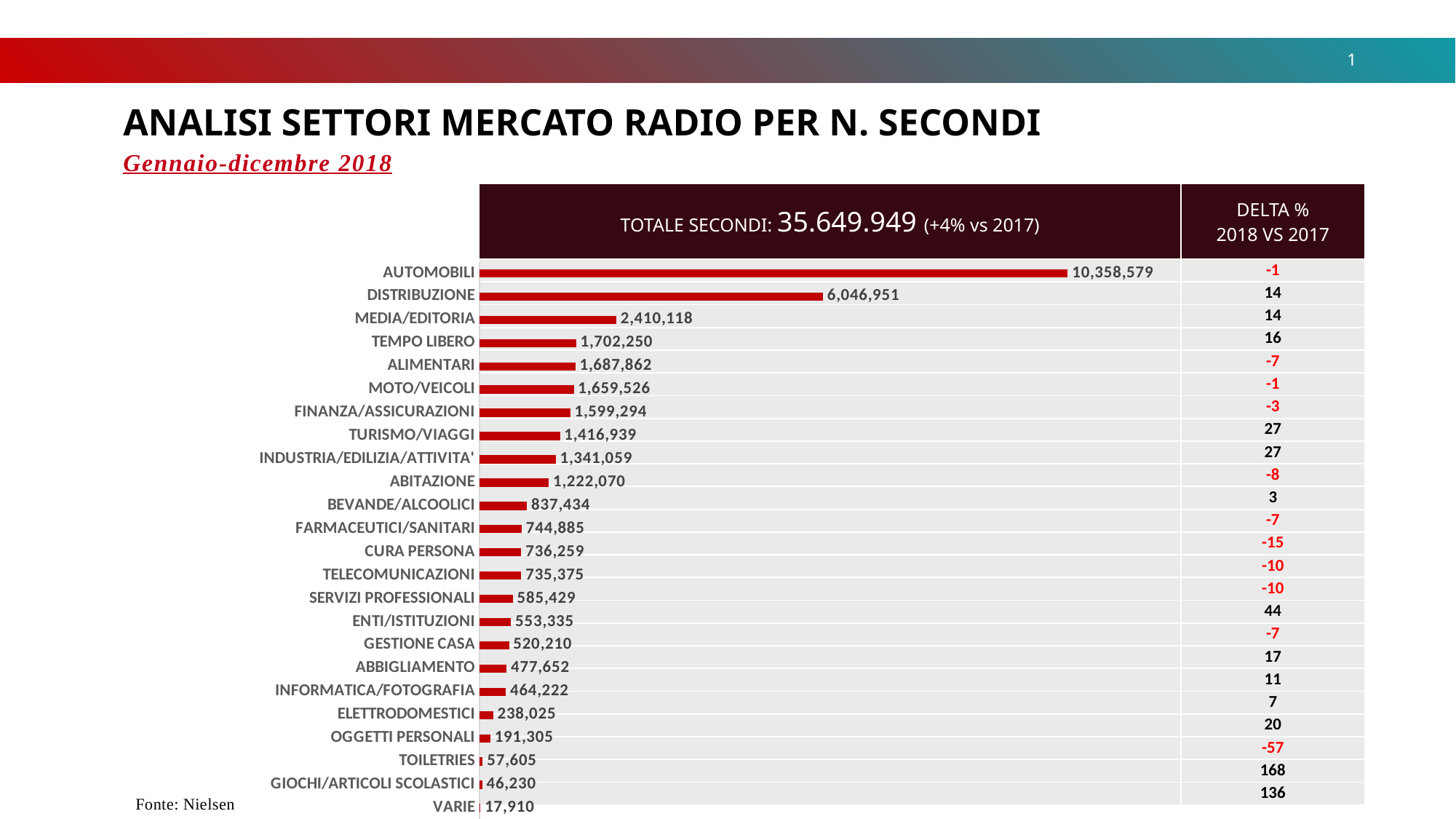
How many categories are shown in the chart? 24 What is the value for DISTRIBUZIONE? 6,046,951 What is the difference between the values for AUTOMOBILI and DISTRIBUZIONE? 4,311,628 Which category has the lowest value? VARIE Which category has the highest value? AUTOMOBILI What total number of seconds is stated in the chart header? 35.649.949 What is the value for TURISMO/VIAGGI? 1,416,939 Which is larger, the value for MEDIA/EDITORIA or the value for ABITAZIONE? MEDIA/EDITORIA What is the value for ELETTRODOMESTICI? 238,025 What type of chart is shown on the slide? bar chart What is the difference between the values for TEMPO LIBERO and ALIMENTARI? 14,388 What is the value for AUTOMOBILI? 10,358,579